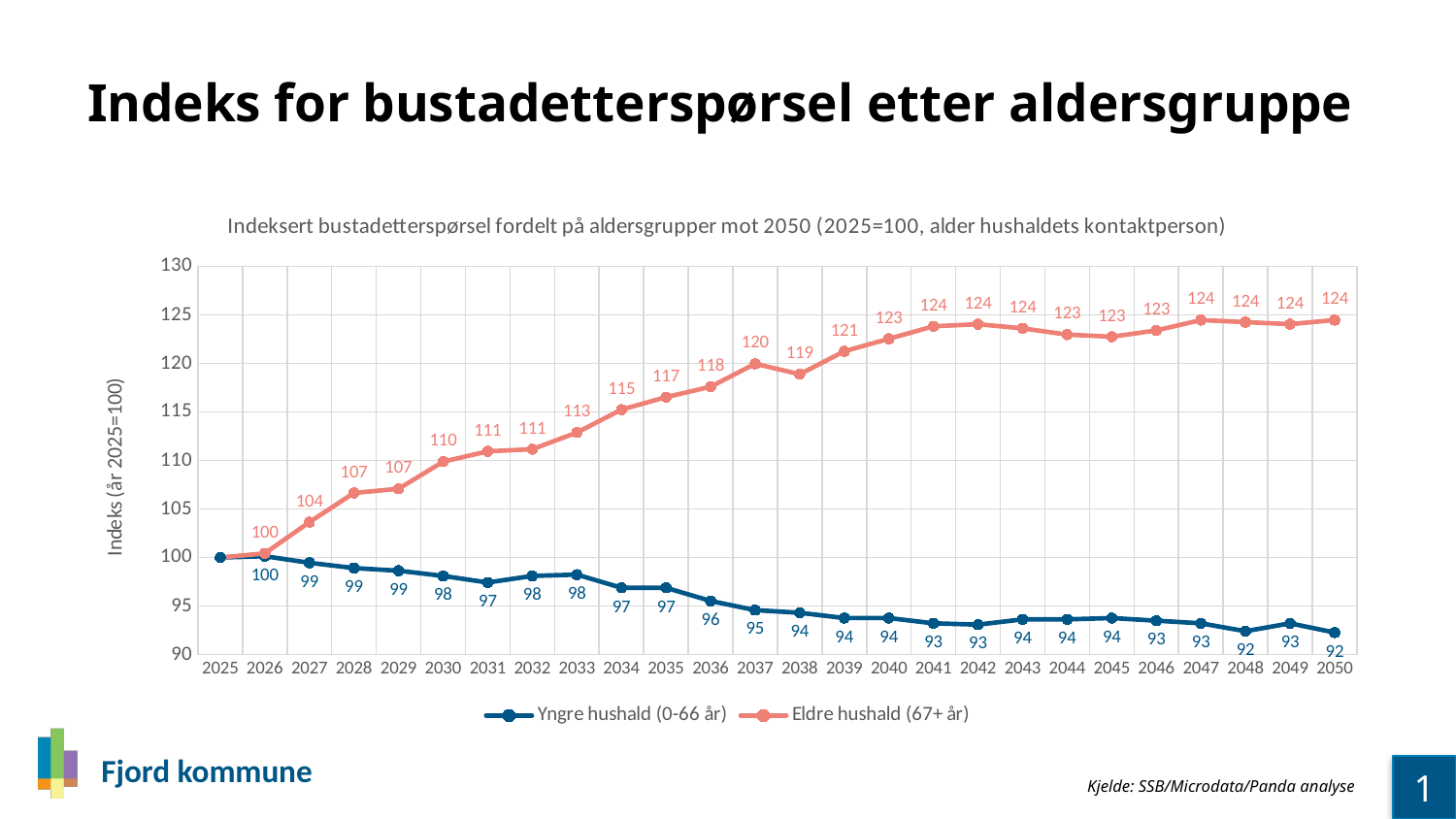
Does the index for Yngre hushald (0-66 år) generally rise or fall from 2025 to 2050? fall What is the index value for Eldre hushald (67+ år) in 2050? 124 Which series has the higher index value in 2040, Yngre hushald (0-66 år) or Eldre hushald (67+ år)? Eldre hushald (67+ år) What is the difference between the Eldre hushald (67+ år) and Yngre hushald (0-66 år) index values in 2050? 32 Is the value for Eldre hushald (67+ år) in 2045 greater or less than 120? greater What is the index value for Yngre hushald (0-66 år) in 2036? 96 What is the label of the y axis? Indeks (år 2025=100) How many series does the legend list? 2 What is the index value for Eldre hushald (67+ år) in 2037? 120 What type of chart is shown on the slide? line chart How many years are shown on the x axis? 26 What is the index value for Yngre hushald (0-66 år) in 2050? 92